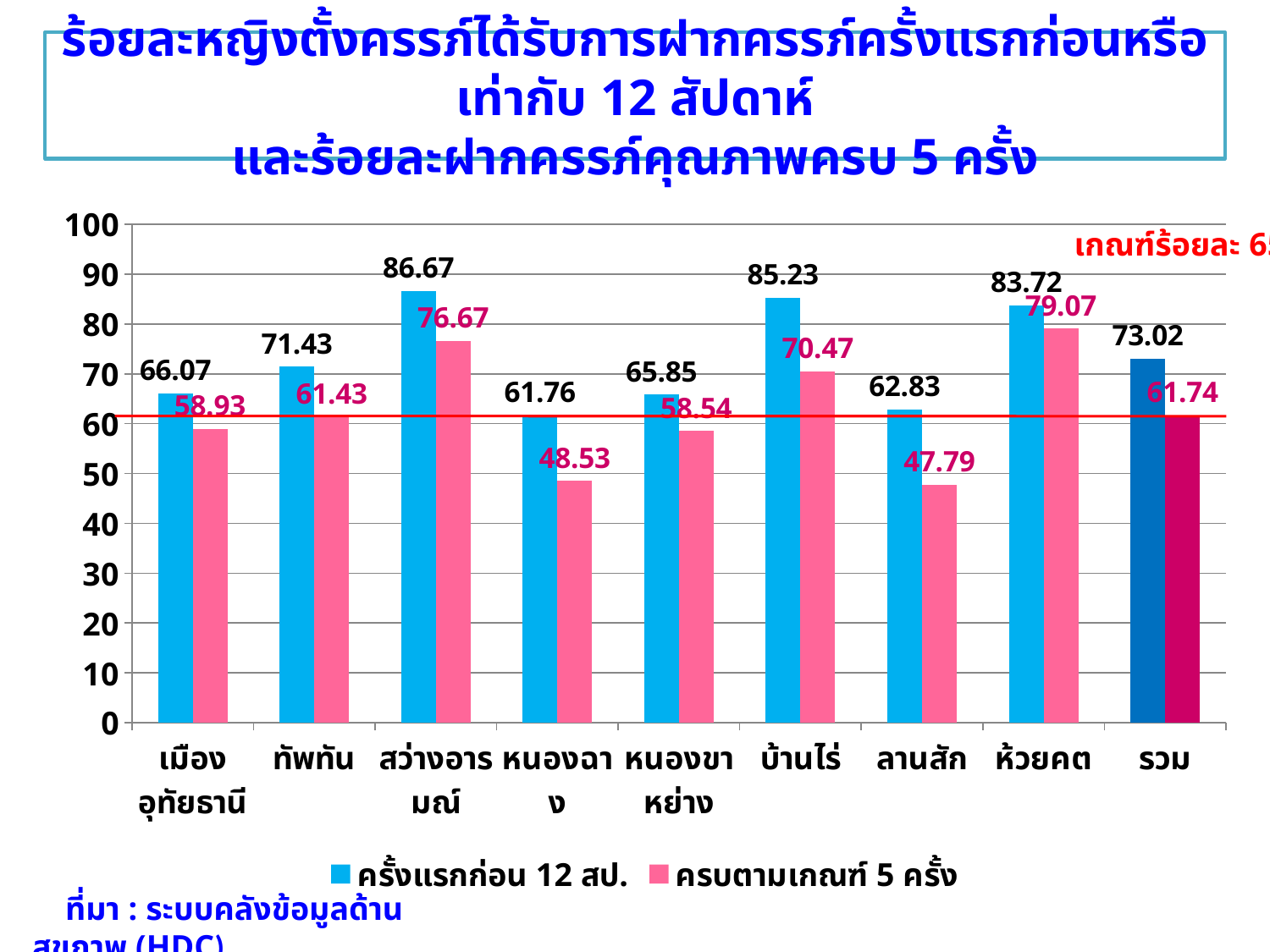
What is the value of ครบตามเกณฑ์ 5 ครั้ง for รวม? 61.74 How many series does the legend list? 2 Which category has the lowest value for ครั้งแรกก่อน 12 สป.? หนองฉาง Which category has the highest value for ครบตามเกณฑ์ 5 ครั้ง? ห้วยคต How many categories are shown on the x axis? 9 What type of chart is shown on the slide? bar chart Is the ครบตามเกณฑ์ 5 ครั้ง value for ห้วยคต greater or less than 70? greater What is the difference between the ครั้งแรกก่อน 12 สป. and ครบตามเกณฑ์ 5 ครั้ง values for หนองฉาง? 13.23 Which category has the highest value for ครั้งแรกก่อน 12 สป.? สว่างอารมณ์ What is the value of ครั้งแรกก่อน 12 สป. for สว่างอารมณ์? 86.67 What is the value of ครบตามเกณฑ์ 5 ครั้ง for ลานสัก? 47.79 Which is larger for บ้านไร่: ครั้งแรกก่อน 12 สป. or ครบตามเกณฑ์ 5 ครั้ง? ครั้งแรกก่อน 12 สป.